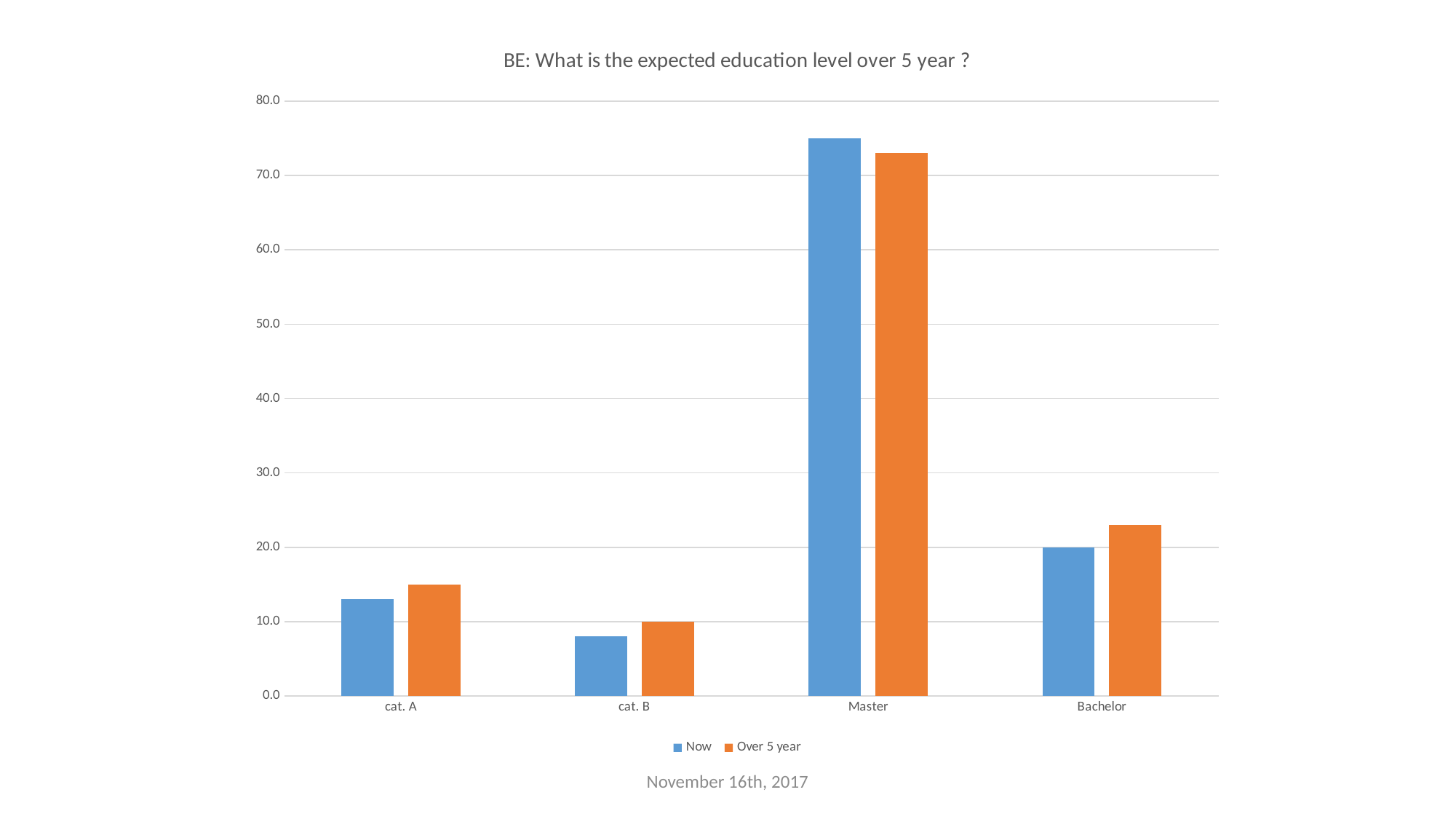
Is the Now value for Master greater or less than 70? greater Which category has the highest value for the Now series? Master For Bachelor, which series has the larger value, Now or Over 5 year? Over 5 year Which series is shown in orange in the legend? Over 5 year How many series does the legend list? 2 What kind of chart is shown on the slide? bar chart Is the Now value for cat. A greater or less than 10? greater What is the title of the chart? BE: What is the expected education level over 5 year ? How many categories are shown on the x axis? 4 Is the Now value for cat. B greater or less than 10? less Which category has the lowest value for the Over 5 year series? cat. B